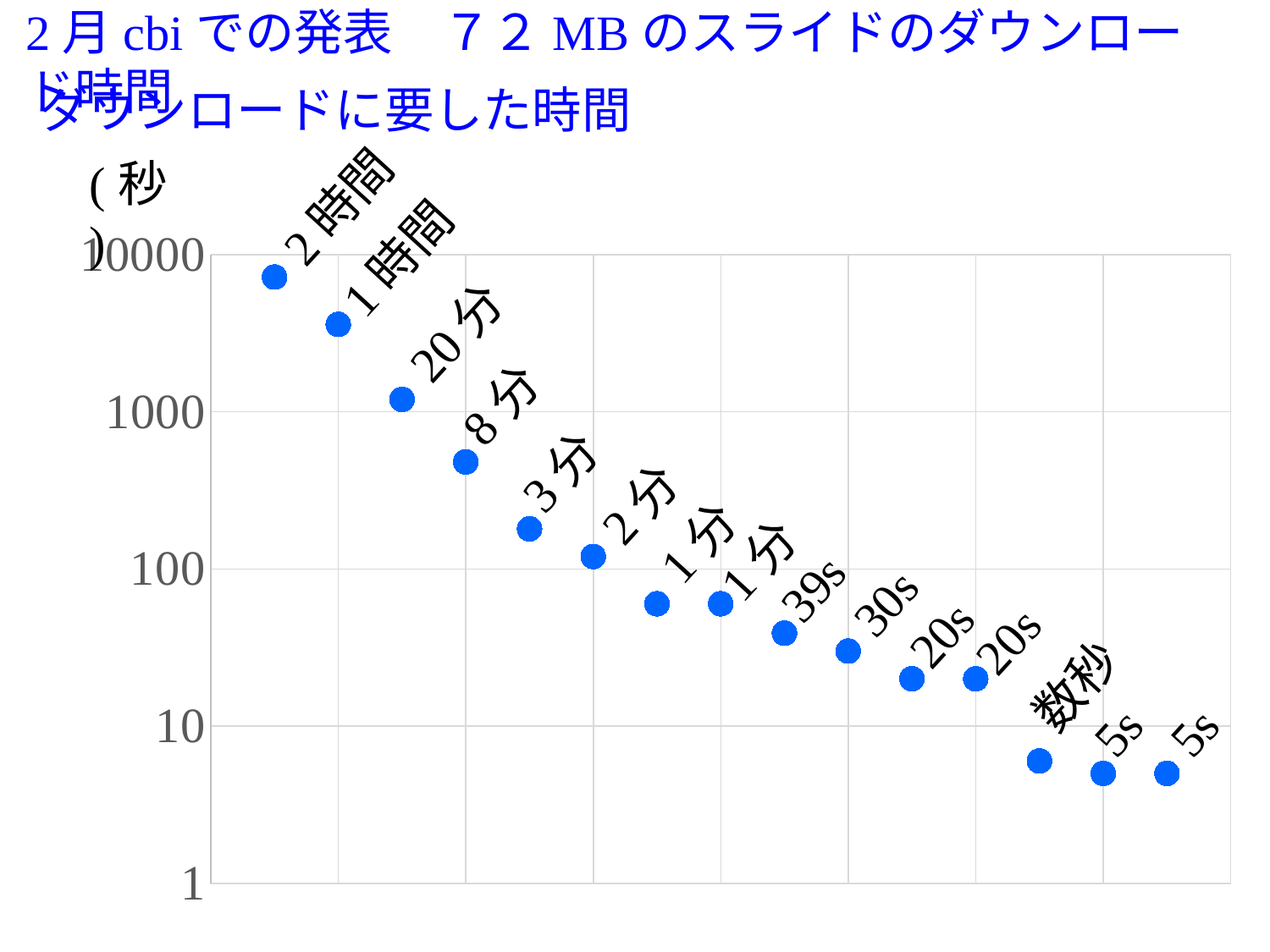
Is the value of the point labeled 8分 greater or less than 1000 seconds? less What unit is shown for the y axis of the chart? 秒 What is the data label on the rightmost point of the chart? 5s Is the value of the point labeled 39s greater or less than 100 seconds? less How many data points are plotted on the chart? 15 What is the data label on the leftmost (highest) point of the chart? 2時間 What kind of chart is shown on the slide? scatter chart Is the value of the point labeled 3分 greater or less than 100 seconds? greater What is the title of the chart? ダウンロードに要した時間 Do the plotted values rise or fall from left to right along the x axis? fall What is the data label on the second point from the left? 1時間